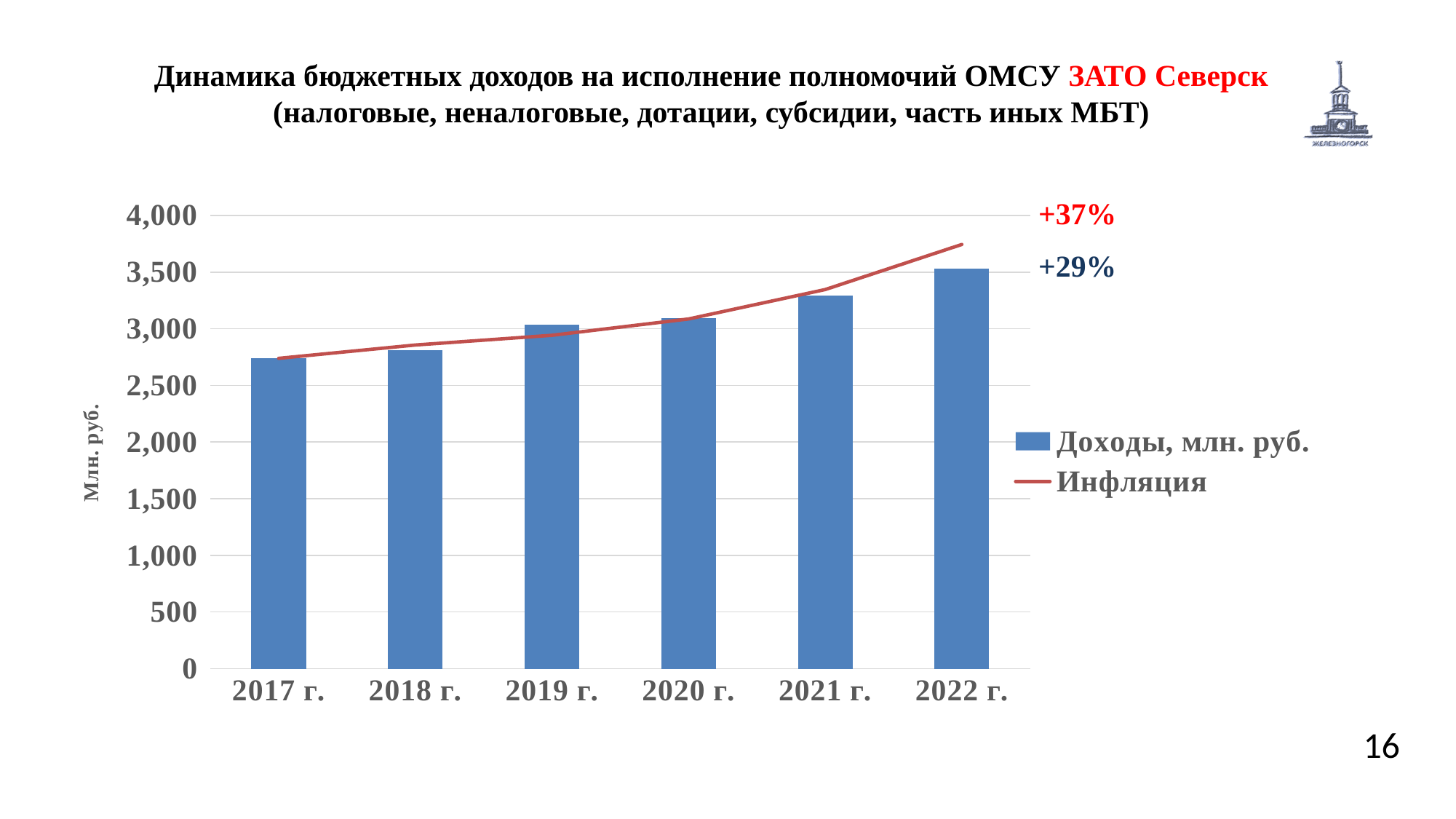
What is the label on the vertical axis of the chart? млн. руб. How many series does the chart legend list? 2 How many years are shown on the x axis of the chart? 6 Which is larger, the Доходы value for 2021 г. or for 2018 г.? 2021 г. Is the value for Доходы in 2017 г. greater or less than 3,000? less Is the value for Доходы in 2022 г. greater or less than 3,000? greater What kind of chart is shown on the slide? bar chart with a line Is the value for Доходы in 2021 г. greater or less than 3,000? greater Do the Доходы bars rise or fall from 2017 г. to 2022 г.? rise Which year has the lowest value for Доходы, млн. руб.? 2017 г. Which year has the highest value for Доходы, млн. руб.? 2022 г.